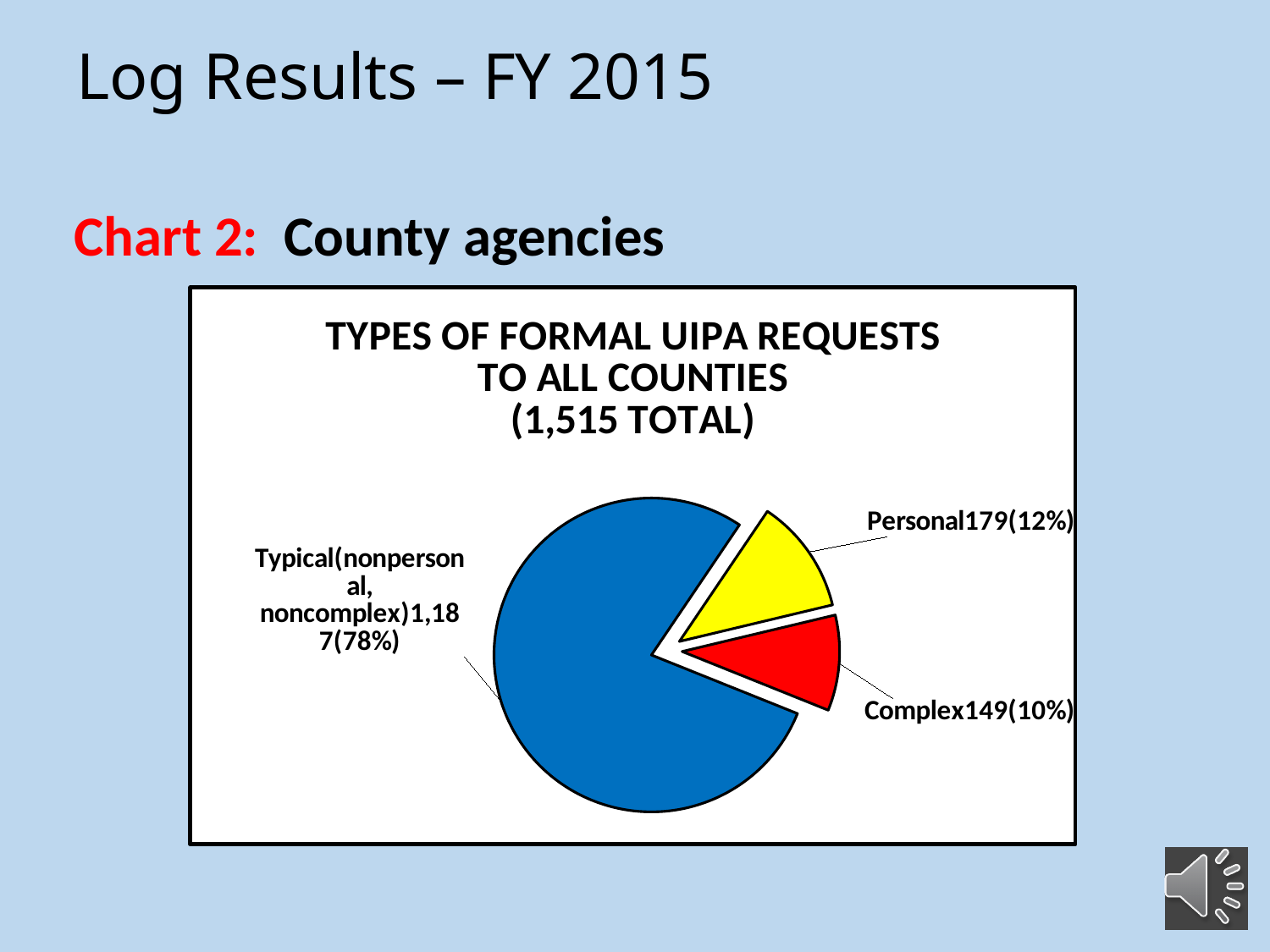
Which category has the largest slice? Typical (nonpersonal, noncomplex) What type of chart is shown on the slide? Pie chart What share of the pie is Personal requests? 12% What total number of requests is stated in the chart title? 1,515 What is the difference between the Personal and Complex values? 30 What share of the pie is Typical (nonpersonal, noncomplex) requests? 78% Which category has the smallest slice? Complex How many slices does the pie chart have? 3 What is the value for Complex requests? 149 What is the value for Personal requests? 179 What is the value for Typical (nonpersonal, noncomplex) requests? 1,187 What share of the pie is Complex requests? 10%